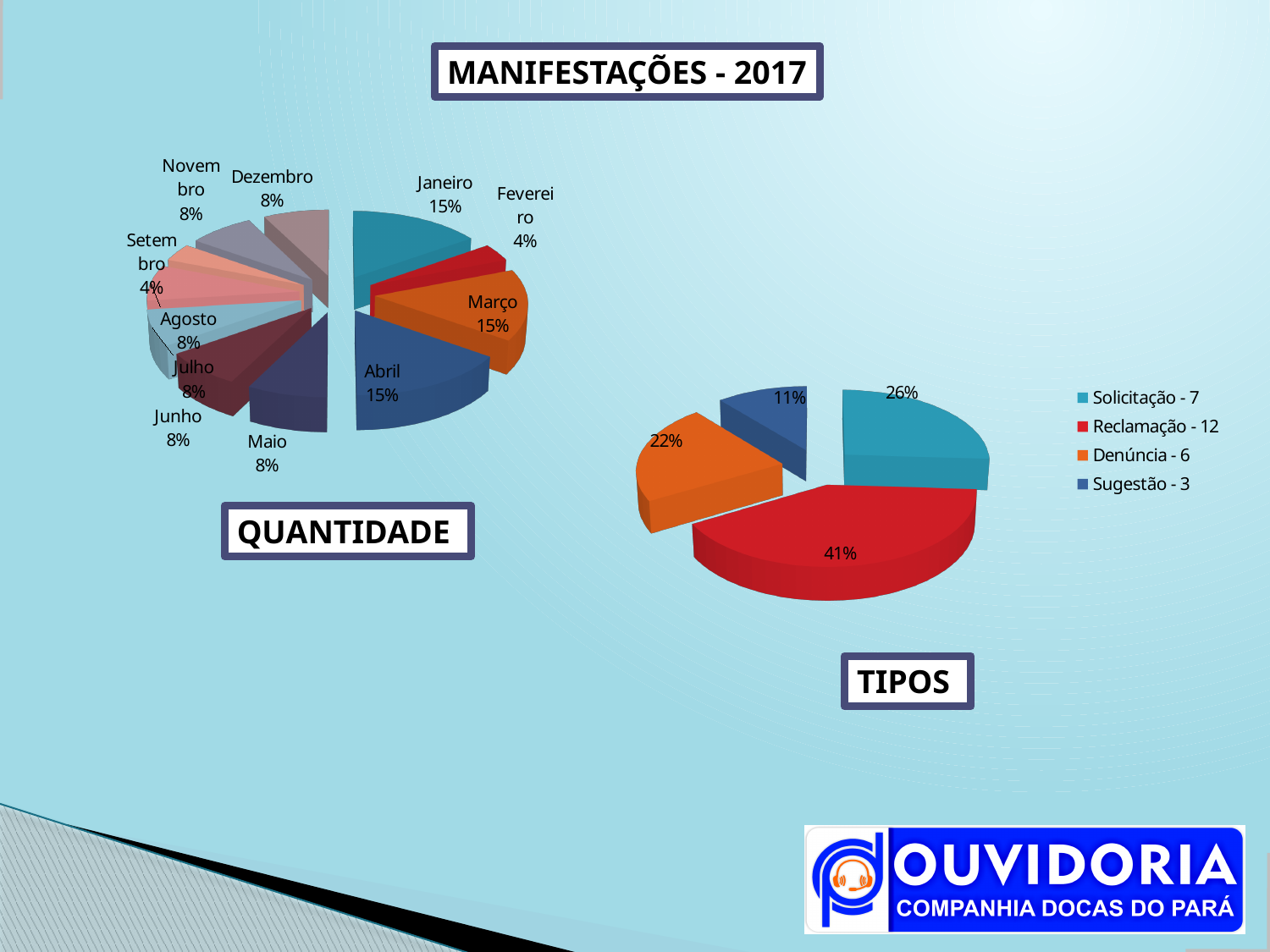
In the TIPOS pie chart, how many percentage points larger is Reclamação's share than Denúncia's? 19 percentage points How many entries does the legend of the TIPOS chart list? 4 In the QUANTIDADE pie chart, which has the larger share, Março or Maio? Março In the QUANTIDADE pie chart, what share does Fevereiro have? 4% In the QUANTIDADE pie chart, what share does Janeiro have? 15% According to the legend of the TIPOS chart, how many Denúncia manifestations were there? 6 In the TIPOS pie chart, which type has the largest share? Reclamação In the TIPOS pie chart, which type has the smallest share? Sugestão What kind of chart is the QUANTIDADE chart? Pie chart In the TIPOS pie chart, what share does Reclamação have? 41% What kind of chart is the TIPOS chart? Pie chart